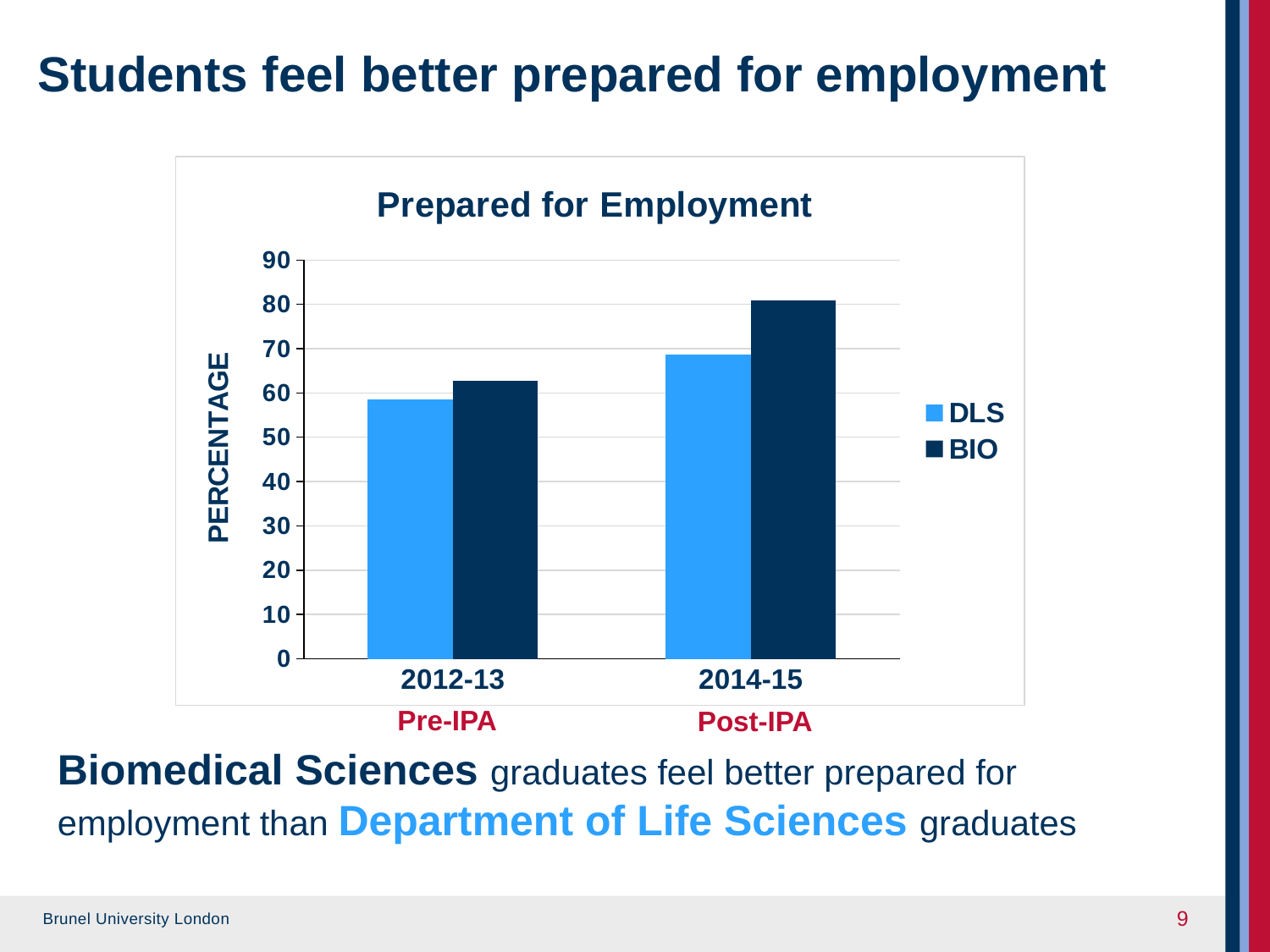
Do the DLS values rise or fall from 2012-13 to 2014-15? rise In 2014-15, which series has the larger value, DLS or BIO? BIO Is the value for BIO in 2014-15 greater or less than 70? greater Is the value for DLS in 2014-15 greater or less than 60? greater Is the value for BIO in 2012-13 greater or less than 70? less Which series and year has the lowest bar? DLS in 2012-13 How many series does the legend list? 2 How many categories are shown on the x axis? 2 Which series and year has the highest bar? BIO in 2014-15 What kind of chart is shown on the slide? bar chart What is the title of the chart? Prepared for Employment